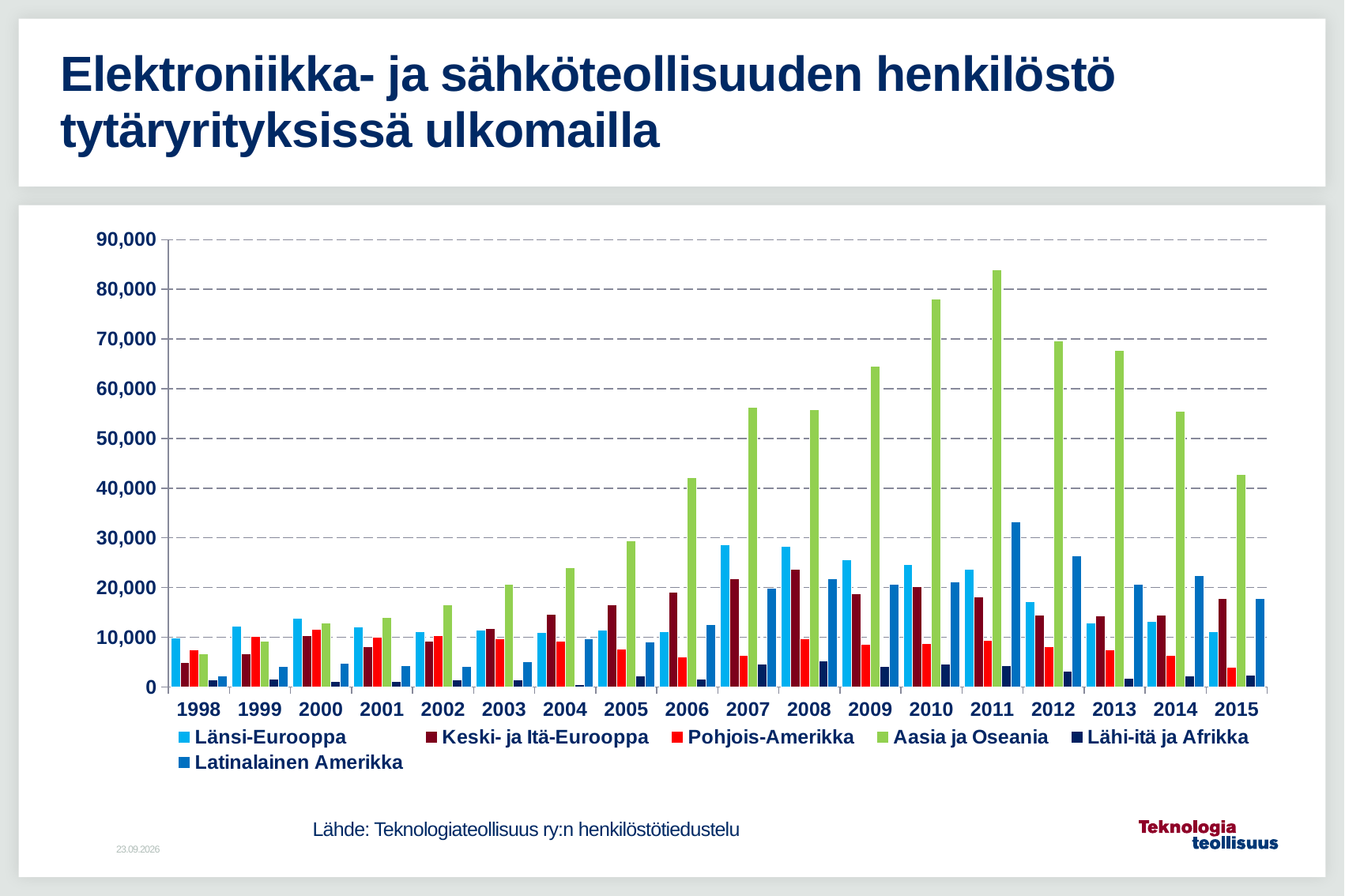
Is the value for Latinalainen Amerikka in 2011 greater or less than 30,000? greater In 2007, which is larger: Länsi-Eurooppa or Aasia ja Oseania? Aasia ja Oseania Does the value for Aasia ja Oseania rise or fall from 2011 to 2015? fall In which year is the value for Aasia ja Oseania highest? 2011 Is the value for Aasia ja Oseania in 2011 greater or less than 80,000? greater Is the value for Aasia ja Oseania in 2010 greater or less than 70,000? greater How many series does the legend list? 6 In 1998, which is larger: Länsi-Eurooppa or Aasia ja Oseania? Länsi-Eurooppa How many years are shown on the x axis? 18 What kind of chart is shown on the slide? bar chart Which series has the lowest value in 2015? Lähi-itä ja Afrikka